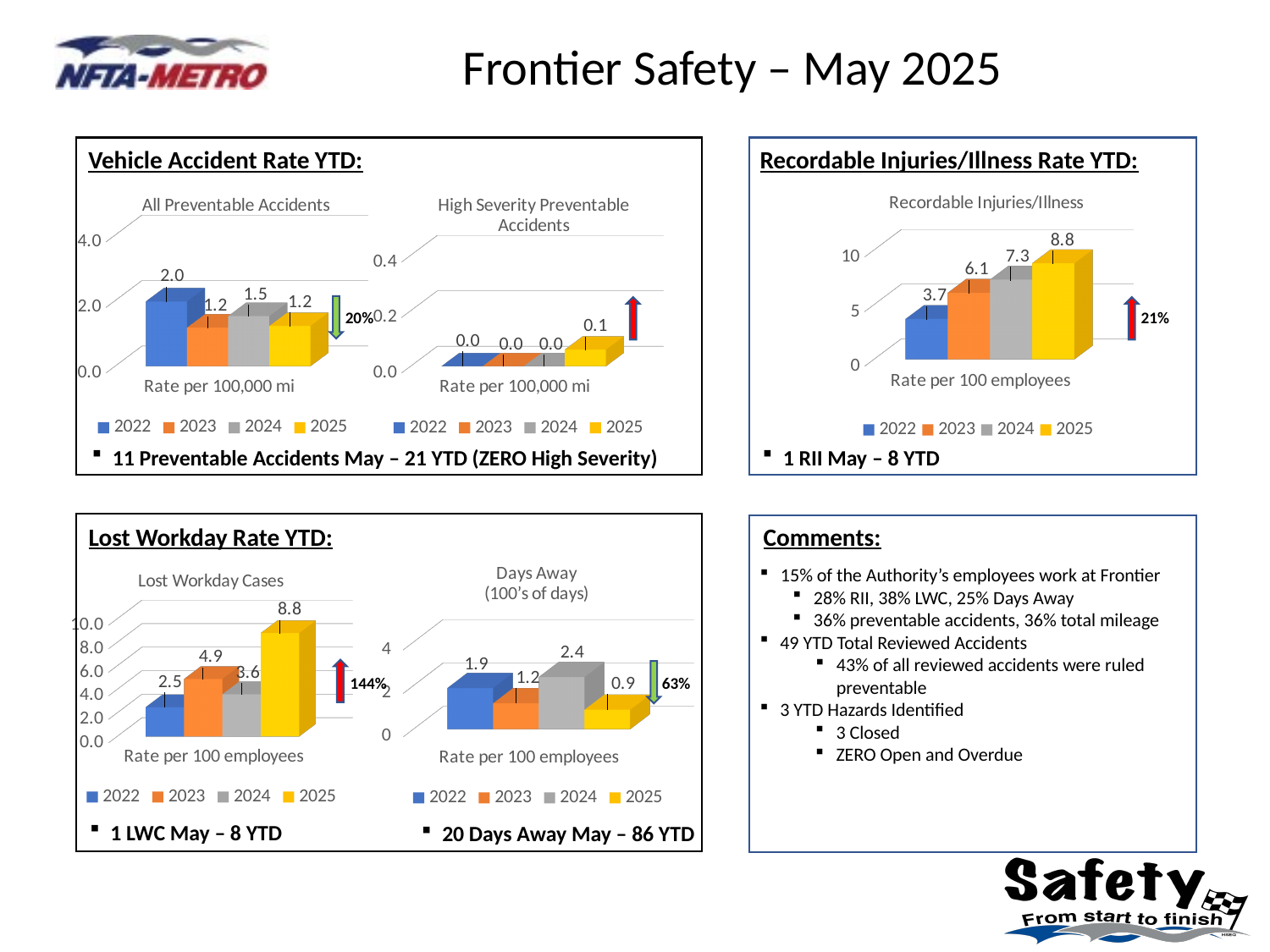
In the "Recordable Injuries/Illness" chart, do the values rise or fall from 2022 to 2025? Rise In the "All Preventable Accidents" chart, what is the value for 2022? 2.0 In the "Days Away (100's of days)" chart, which year has the lowest value? 2025 In the "Lost Workday Cases" chart, which is larger, the value for 2023 or the value for 2024? 2023 In the "Lost Workday Cases" chart, which year has the highest value? 2025 In the "Recordable Injuries/Illness" chart, what is the difference between the 2025 and 2022 values? 5.1 In the "Days Away (100's of days)" chart, what is the value for 2024? 2.4 What kind of chart is the "Lost Workday Cases" chart? Bar chart In the "Recordable Injuries/Illness" chart, what is the value for 2025? 8.8 How many series does the legend of the "Recordable Injuries/Illness" chart list? 4 In the "High Severity Preventable Accidents" chart, what is the value for 2025? 0.1 What is the x-axis label shown under the bars in the "Recordable Injuries/Illness" chart? Rate per 100 employees